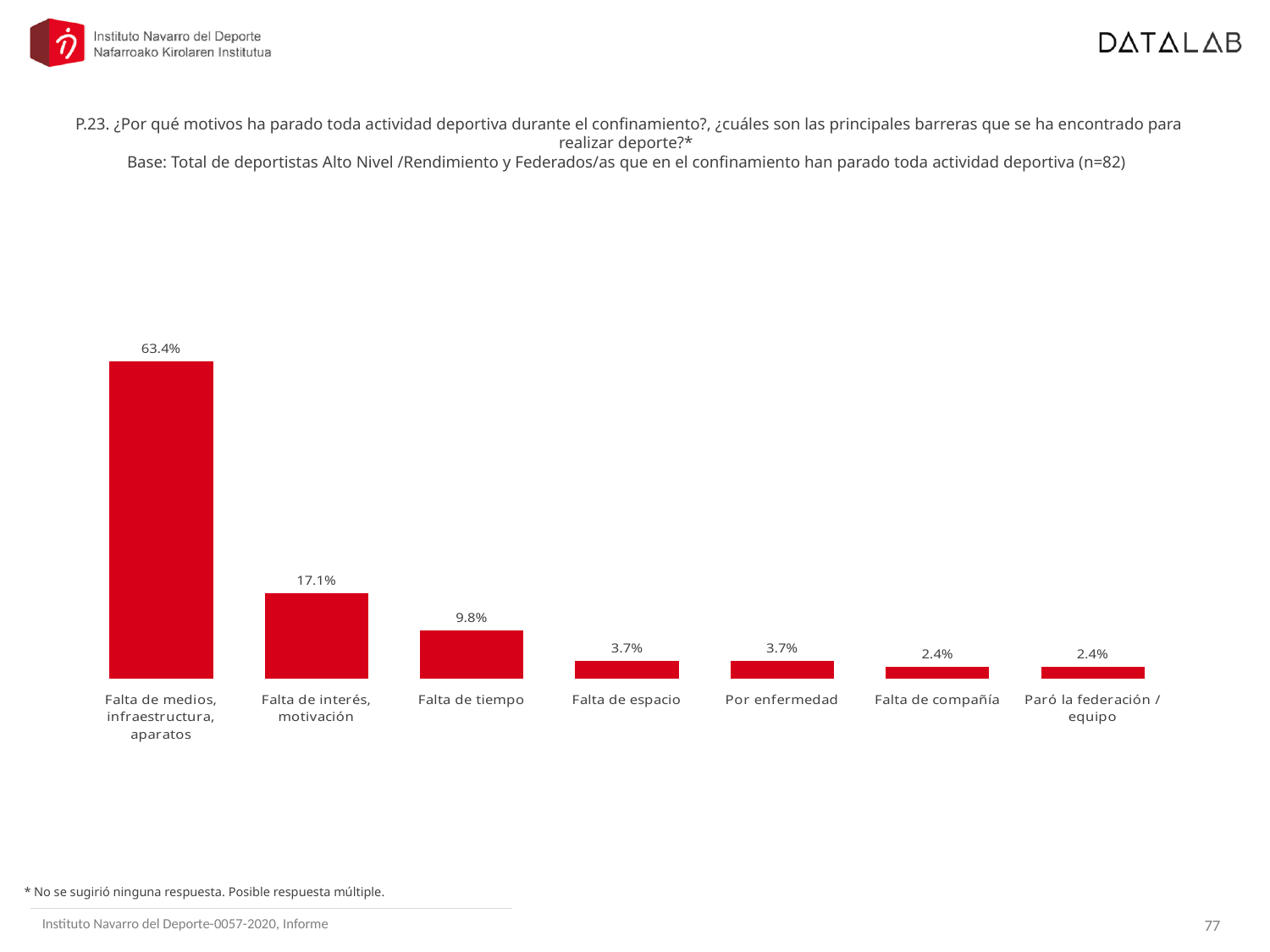
What is the value for "Falta de tiempo"? 9.8% What is the difference between "Falta de tiempo" and "Falta de espacio"? 6.1% How many categories are shown in the chart? 7 Which is larger, "Falta de interés, motivación" or "Falta de tiempo"? Falta de interés, motivación What is the value for "Falta de medios, infraestructura, aparatos"? 63.4% What is the difference between "Falta de medios, infraestructura, aparatos" and "Falta de interés, motivación"? 46.3% What is the value for "Falta de interés, motivación"? 17.1% Do the values rise or fall from left to right along the x axis? Fall What is the value for "Por enfermedad"? 3.7% What kind of chart is shown on the slide? Bar chart What is the base size (n) stated in the chart title? n=82 Which category has the highest value? Falta de medios, infraestructura, aparatos